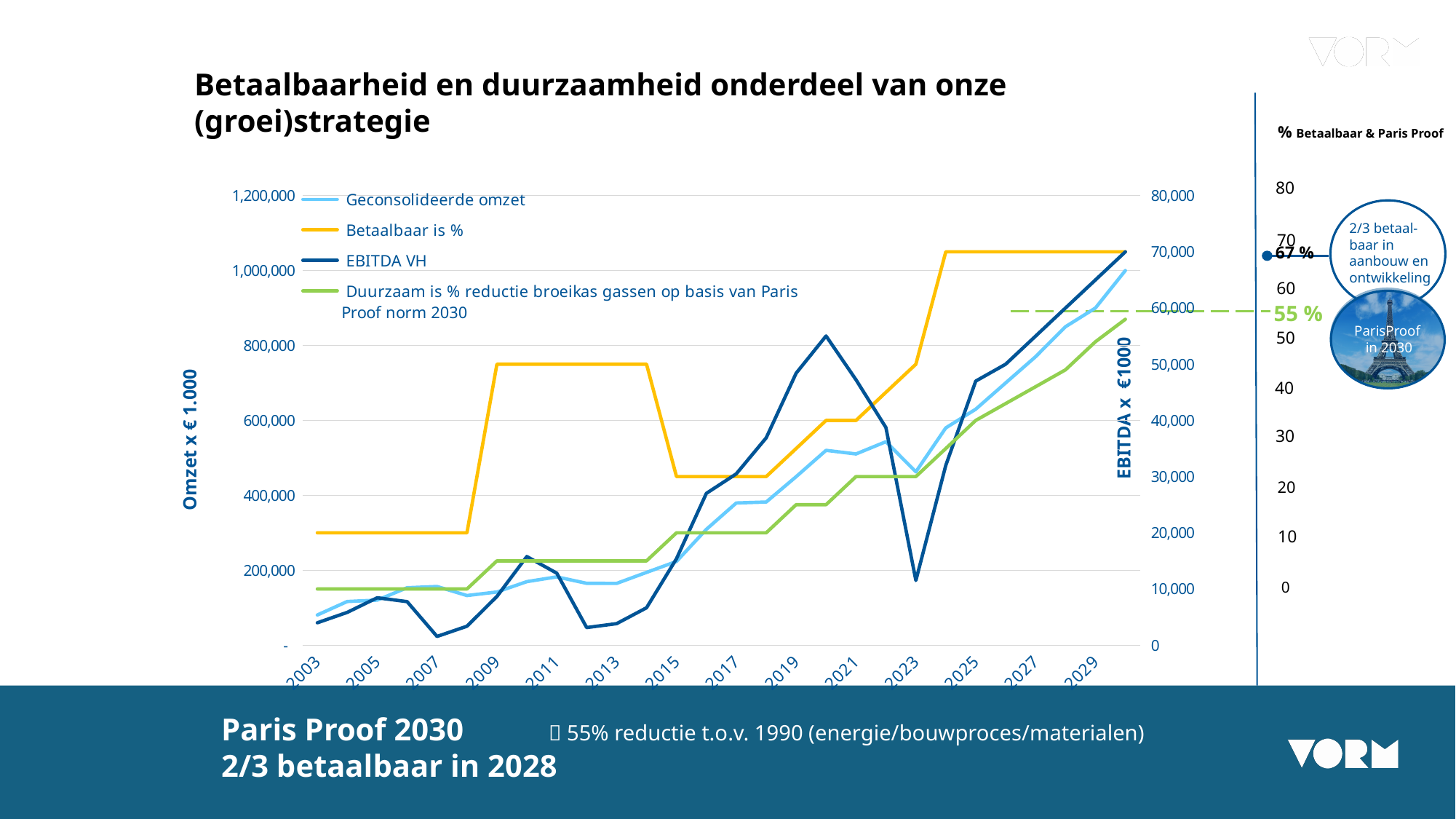
What is the title of the slide containing the chart? Betaalbaarheid en duurzaamheid onderdeel van onze (groei)strategie How many series does the chart legend list? 4 Is the Geconsolideerde omzet value in 2029 greater or less than 800,000 on the left axis? greater Is the EBITDA VH value in 2023 greater or less than 20,000 on the right axis? less What percentage is marked by the green dashed line for Paris Proof in 2030? 55 % Which series is drawn in green in the chart? Duurzaam is % reductie broeikas gassen op basis van Paris Proof norm 2030 What percentage is marked with a dot on the right-hand '% Betaalbaar & Paris Proof' axis? 67 % Is the EBITDA VH value in 2020 greater or less than 40,000 on the right axis? greater Which year has the higher EBITDA VH value, 2020 or 2023? 2020 Does the Geconsolideerde omzet line rise or fall between 2023 and 2029? rise What kind of chart is shown on the slide? line chart